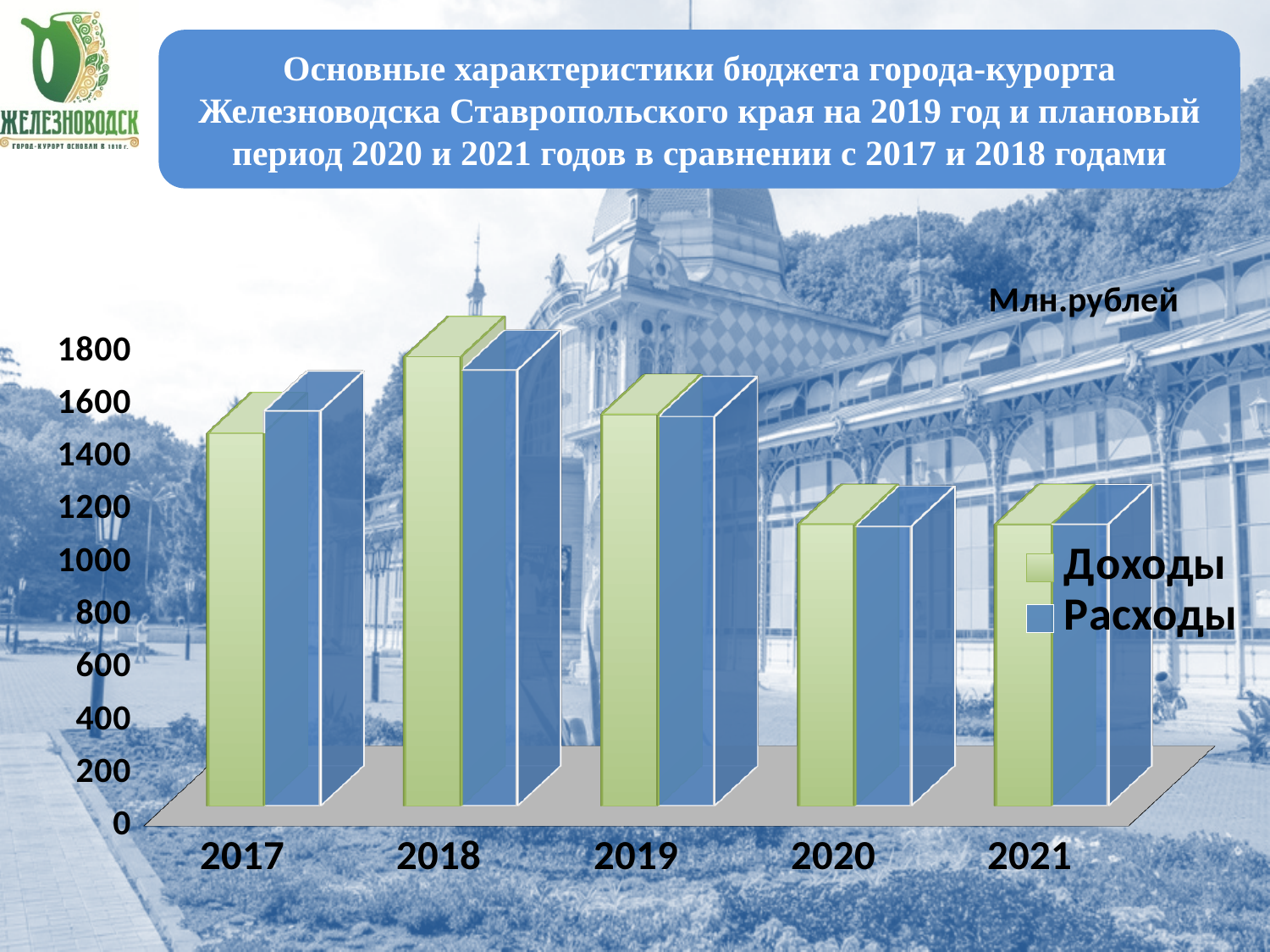
Is the Расходы value for 2021 greater or less than 1400? less In which year is the Доходы bar the highest? 2018 Is the Доходы value for 2018 greater or less than 1600? greater What kind of chart is shown on the slide? Bar chart Is the Доходы value for 2020 greater or less than 1400? less Do the Расходы values rise or fall from 2018 to 2021? fall In which year is the Расходы bar the highest? 2018 Which two series are listed in the chart legend? Доходы and Расходы Which is larger: the Доходы value for 2018 or the Доходы value for 2020? 2018 What unit of measurement is indicated for the chart values? Млн.рублей How many series does the chart legend list? 2 How many years (categories) are shown on the x axis of the chart? 5